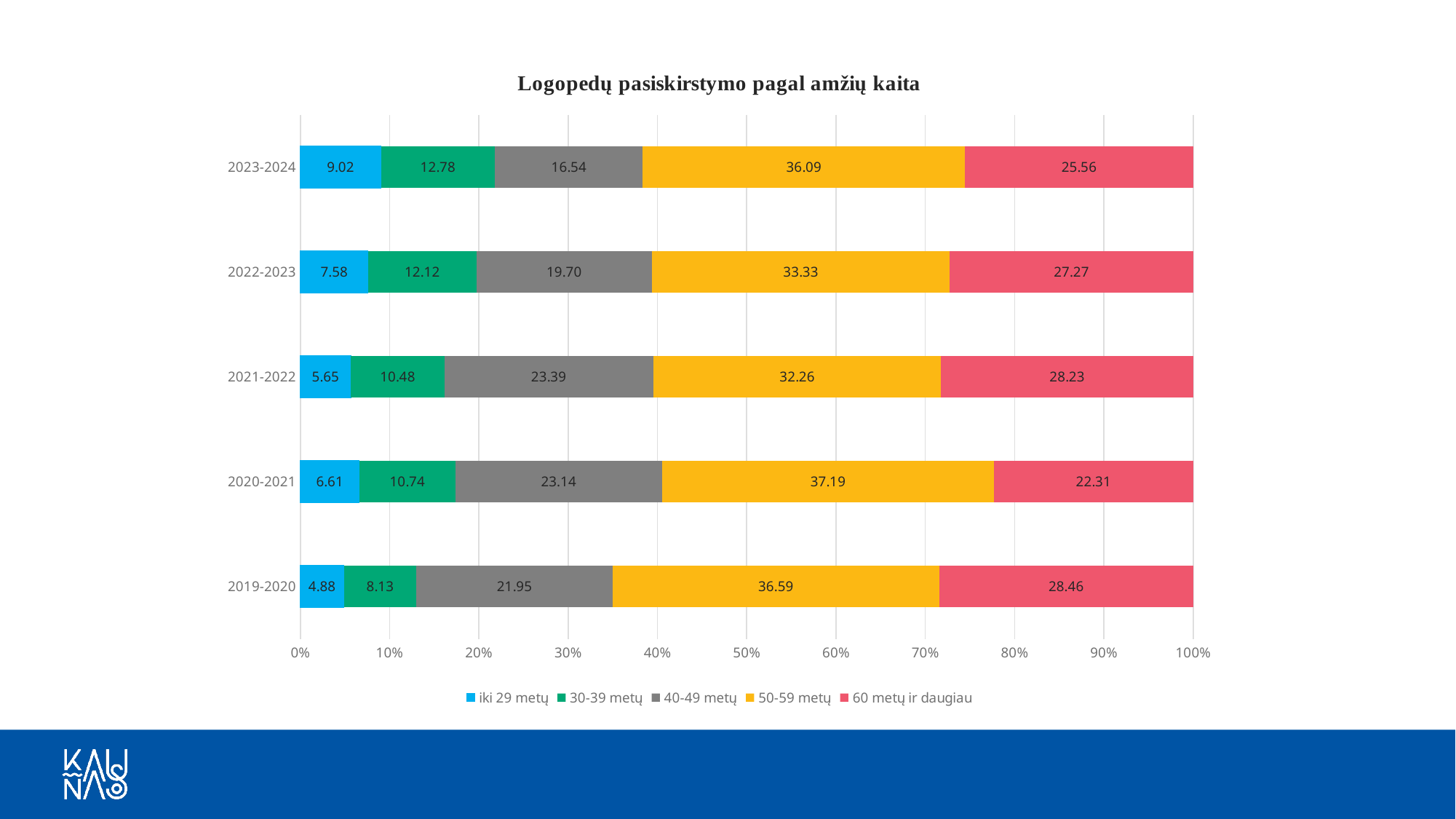
What is the difference between the '50-59 metų' and '60 metų ir daugiau' values in 2023-2024? 10.53 Which year has the highest value for '50-59 metų'? 2020-2021 Which year has the highest value for 'iki 29 metų'? 2023-2024 What is the value for '50-59 metų' in 2019-2020? 36.59 What kind of chart is shown on the slide? Stacked bar chart What is the value for 'iki 29 metų' in 2023-2024? 9.02 How many year categories are shown on the chart? 5 What is the title of the chart? Logopedų pasiskirstymo pagal amžių kaita What is the value for '40-49 metų' in 2021-2022? 23.39 Which year has the lowest value for '60 metų ir daugiau'? 2020-2021 Which is larger: the '40-49 metų' value in 2022-2023 or in 2021-2022? 2021-2022 How many series does the legend list? 5